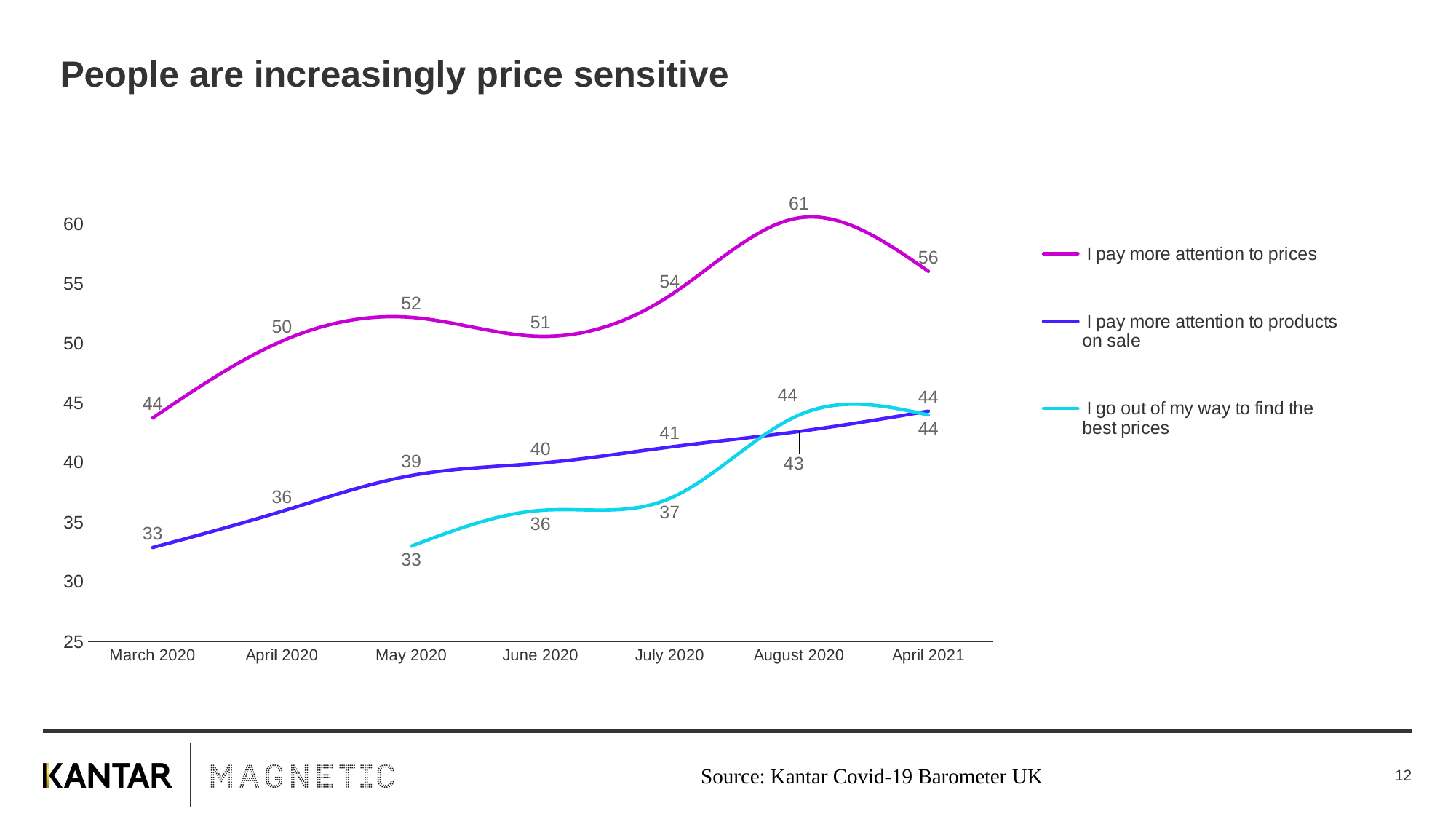
In which month is 'I pay more attention to products on sale' at its lowest value? March 2020 What is the value for 'I go out of my way to find the best prices' in July 2020? 37 What is the value for 'I pay more attention to products on sale' in March 2020? 33 What type of chart is shown on the slide? line chart How many time points are shown on the x axis? 7 Which is larger in June 2020: 'I pay more attention to products on sale' or 'I go out of my way to find the best prices'? I pay more attention to products on sale In which month does 'I pay more attention to prices' reach its highest value? August 2020 Does 'I pay more attention to products on sale' rise or fall from March 2020 to April 2021? rise How many series does the legend list? 3 What is the title of the slide? People are increasingly price sensitive What is the value for 'I pay more attention to prices' in August 2020? 61 What is the difference between the 'I pay more attention to prices' values in August 2020 and April 2021? 5